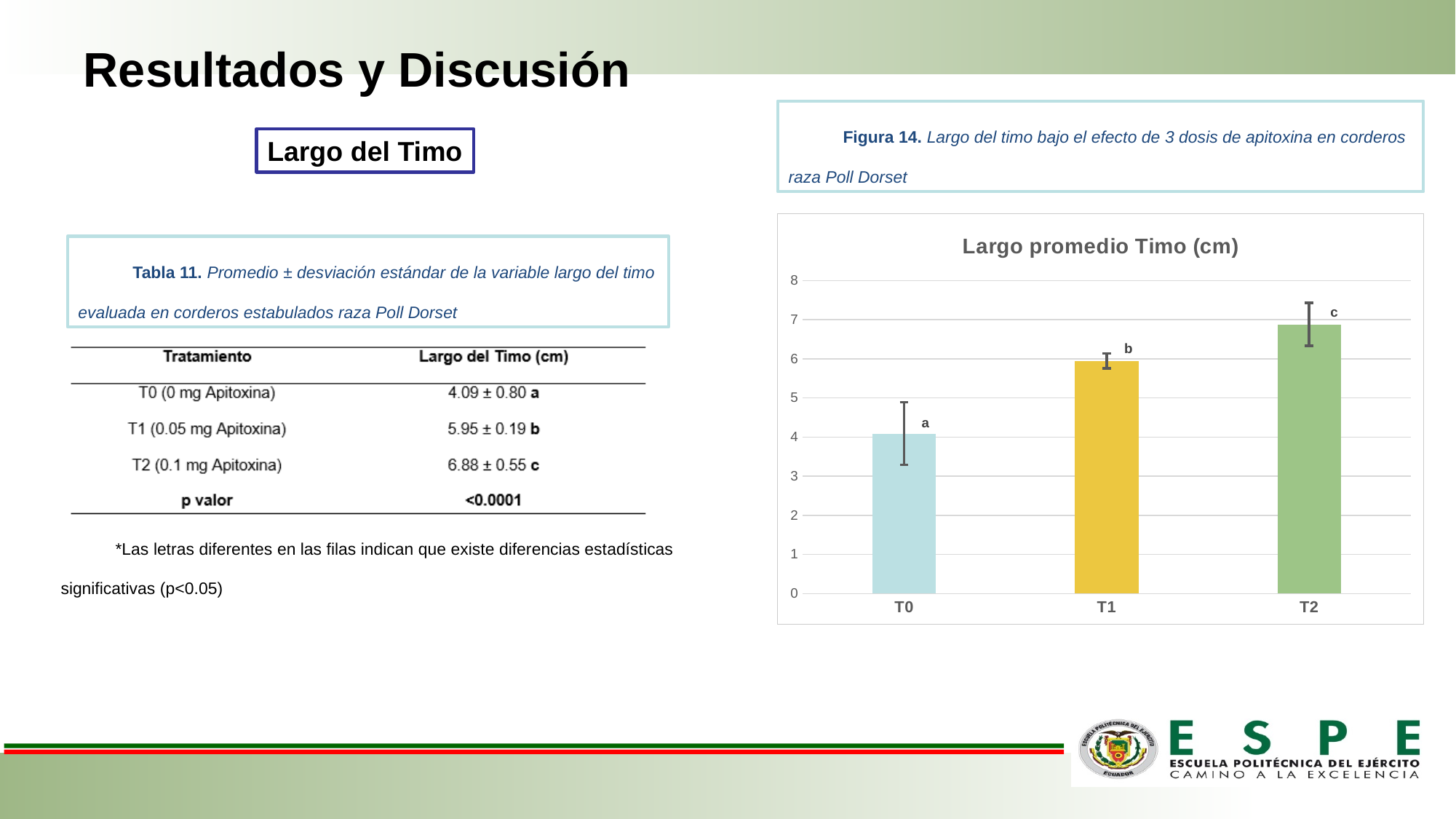
What type of chart is shown under the title "Largo promedio Timo (cm)"? bar chart According to Tabla 11 on the slide, what is the mean thymus length (cm) for T1 (0.05 mg Apitoxina)? 5.95 According to Tabla 11 on the slide, what is the mean thymus length (cm) for T2 (0.1 mg Apitoxina)? 6.88 How many treatment categories are plotted in the "Largo promedio Timo (cm)" chart? 3 In the "Largo promedio Timo (cm)" chart, which bar is taller, T1 or T2? T2 Do the bar heights in the "Largo promedio Timo (cm)" chart rise or fall from T0 to T2? rise In the "Largo promedio Timo (cm)" chart, is the bar for T1 greater or less than 5? greater In the "Largo promedio Timo (cm)" chart, is the bar for T2 greater or less than 6? greater Which treatment has the shortest bar in the "Largo promedio Timo (cm)" chart? T0 In the "Largo promedio Timo (cm)" chart, is the bar for T0 greater or less than 5? less Which treatment has the tallest bar in the "Largo promedio Timo (cm)" chart? T2 What letter is printed above the T2 bar in the "Largo promedio Timo (cm)" chart? c